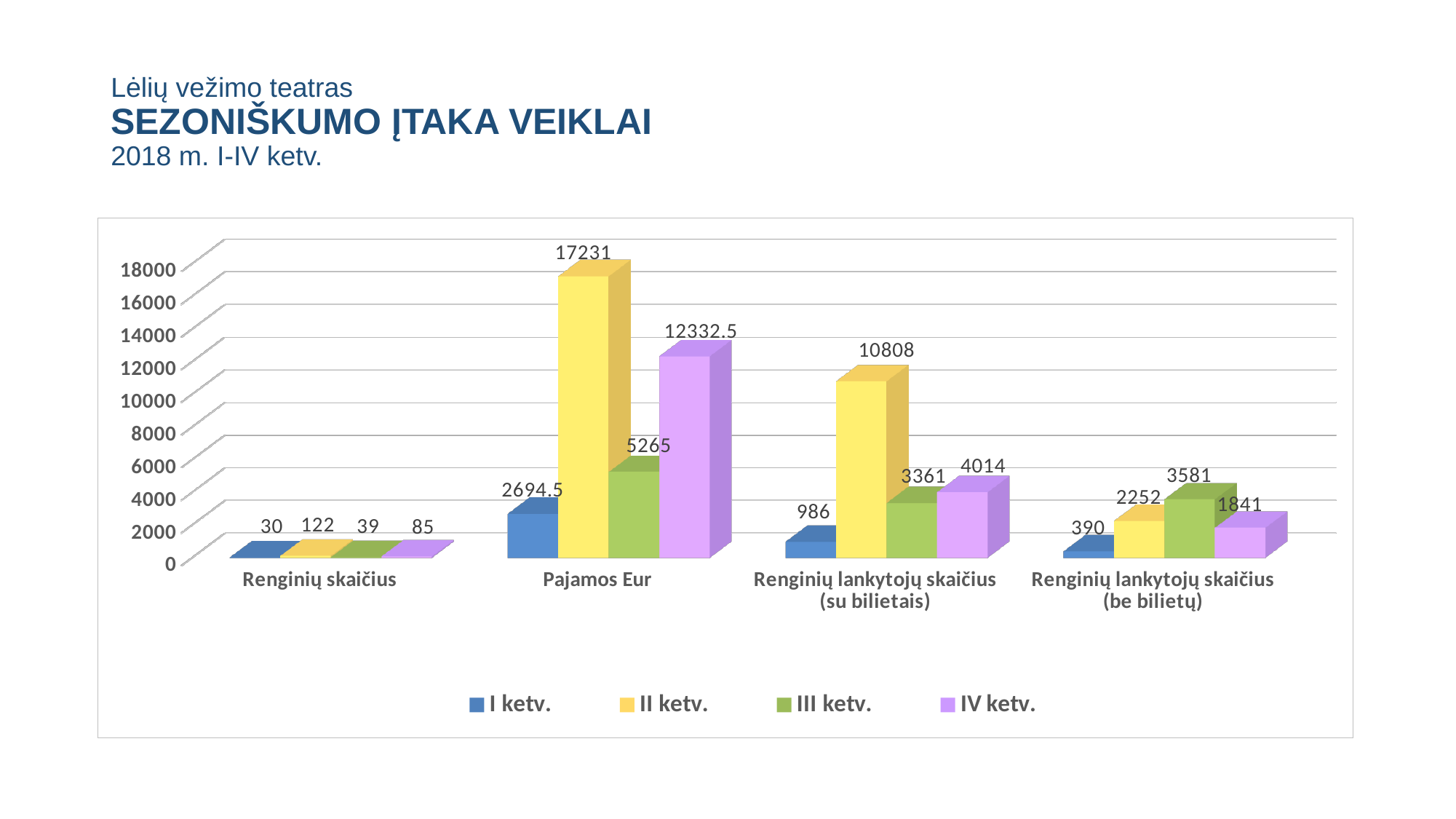
What is the value for IV ketv. in the Renginių lankytojų skaičius (su bilietais) category? 4014 What is the difference between the II ketv. and IV ketv. values in the Pajamos Eur category? 4898.5 What kind of chart is shown on the slide? bar chart Which quarter has the highest value in the Pajamos Eur category? II ketv. How many categories are shown on the x axis? 4 What is the value for II ketv. in the Pajamos Eur category? 17231 How many series does the legend list? 4 What is the value for I ketv. in the Renginių skaičius category? 30 Which quarter has the lowest value in the Renginių skaičius category? I ketv. What is the value for III ketv. in the Renginių lankytojų skaičius (be bilietų) category? 3581 Is the value for II ketv. in the Renginių lankytojų skaičius (su bilietais) category greater or less than 10000? greater Which is larger in the Renginių lankytojų skaičius (be bilietų) category: II ketv. or IV ketv.? II ketv.